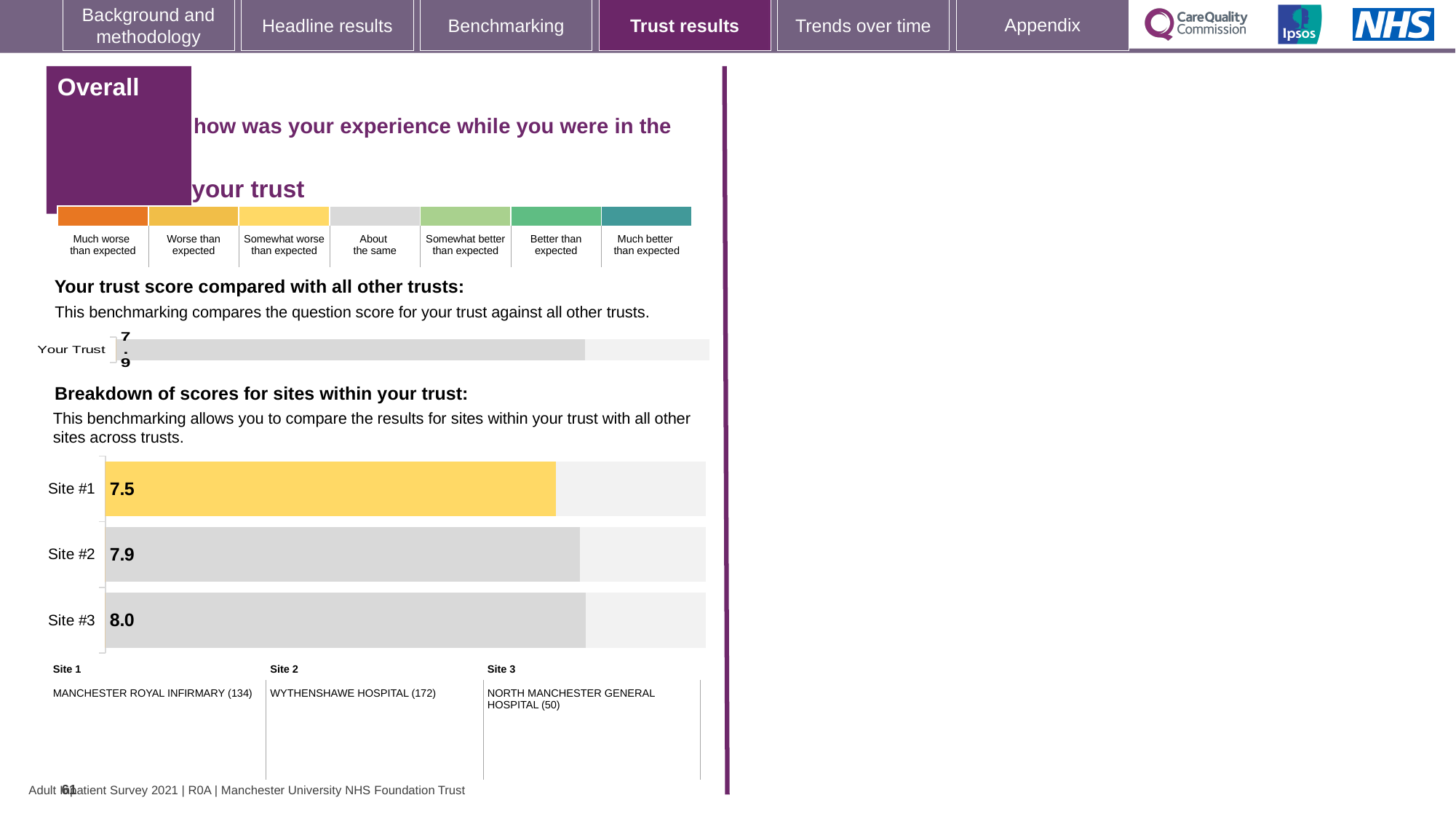
In the 'Breakdown of scores for sites within your trust' chart, what is the score for Site #1? 7.5 In the 'Breakdown of scores for sites within your trust' chart, what is the score for Site #3? 8.0 In the 'Breakdown of scores for sites within your trust' chart, which has a higher score, Site #1 or Site #2? Site #2 According to the key on the slide, which site in the 'Breakdown of scores for sites within your trust' chart is Manchester Royal Infirmary? Site 1 In the 'Breakdown of scores for sites within your trust' chart, which site has the lowest score? Site #1 In the 'Your trust score compared with all other trusts' chart, what is the score for Your Trust? 7.9 In the 'Breakdown of scores for sites within your trust' chart, what is the score for Site #2? 7.9 In the 'Breakdown of scores for sites within your trust' chart, which site's bar is coloured yellow? Site #1 What kind of chart is the 'Breakdown of scores for sites within your trust' chart? Bar chart In the 'Breakdown of scores for sites within your trust' chart, which site has the highest score? Site #3 In the 'Breakdown of scores for sites within your trust' chart, what is the difference between the scores for Site #3 and Site #1? 0.5 How many sites are shown in the 'Breakdown of scores for sites within your trust' chart? 3